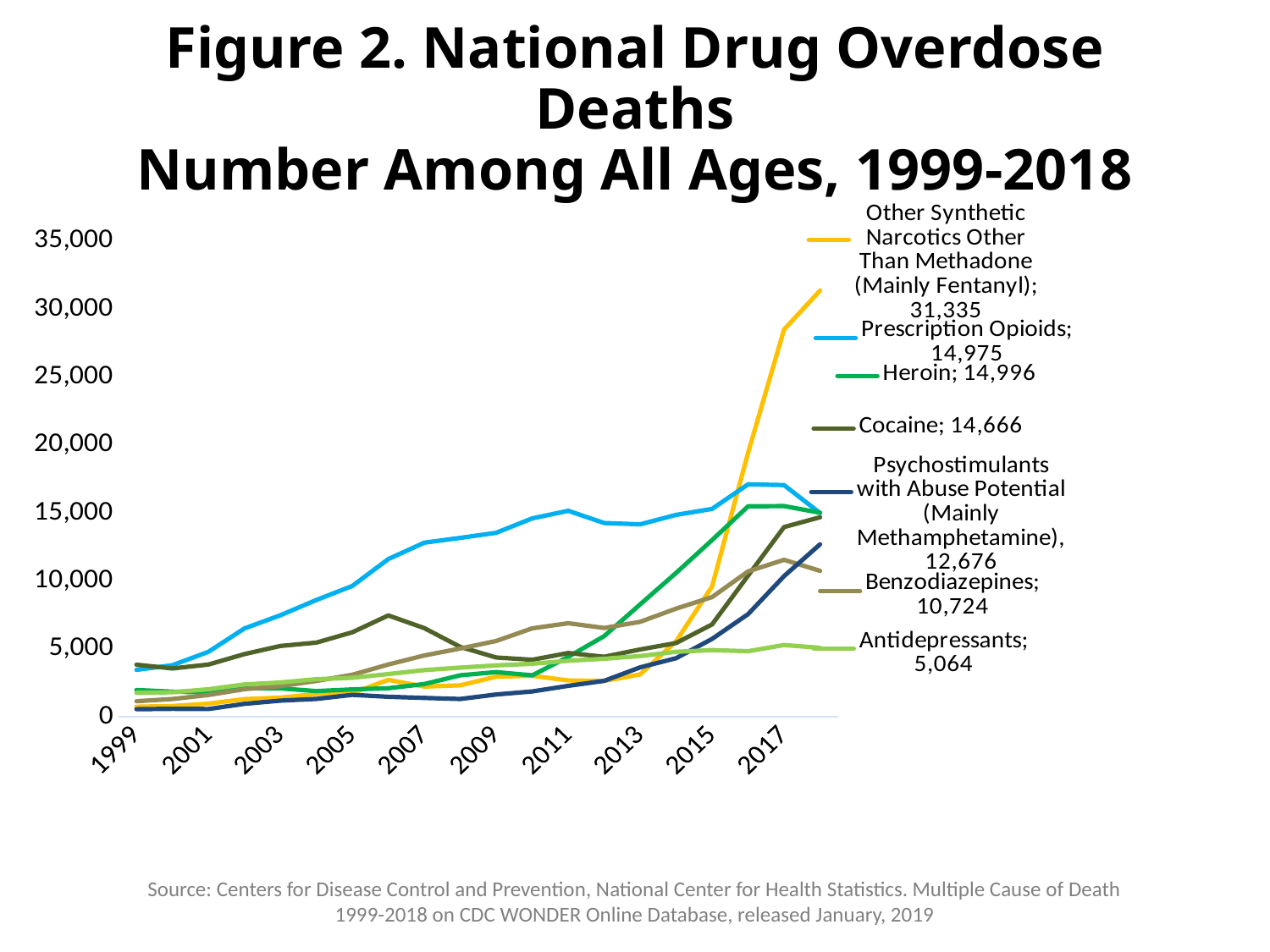
Is the value for Prescription Opioids in 2011 greater or less than 10,000? greater What is the difference between the 2018 values for Other Synthetic Narcotics Other Than Methadone and Prescription Opioids? 16,360 Which series has the lowest value in 2018? Antidepressants Which has the larger 2018 value, Psychostimulants with Abuse Potential or Benzodiazepines? Psychostimulants with Abuse Potential What is the difference between the 2018 values for Psychostimulants with Abuse Potential and Antidepressants? 7,612 What is the 2018 value shown for Heroin? 14,996 Does the Other Synthetic Narcotics Other Than Methadone line rise or fall from 2013 to 2018? rise What range of years does the chart cover according to its title? 1999-2018 What is the 2018 value shown for Benzodiazepines? 10,724 What kind of chart is shown on the slide? line chart Which series has the highest value in 2018? Other Synthetic Narcotics Other Than Methadone (Mainly Fentanyl) How many series does the legend list? 7